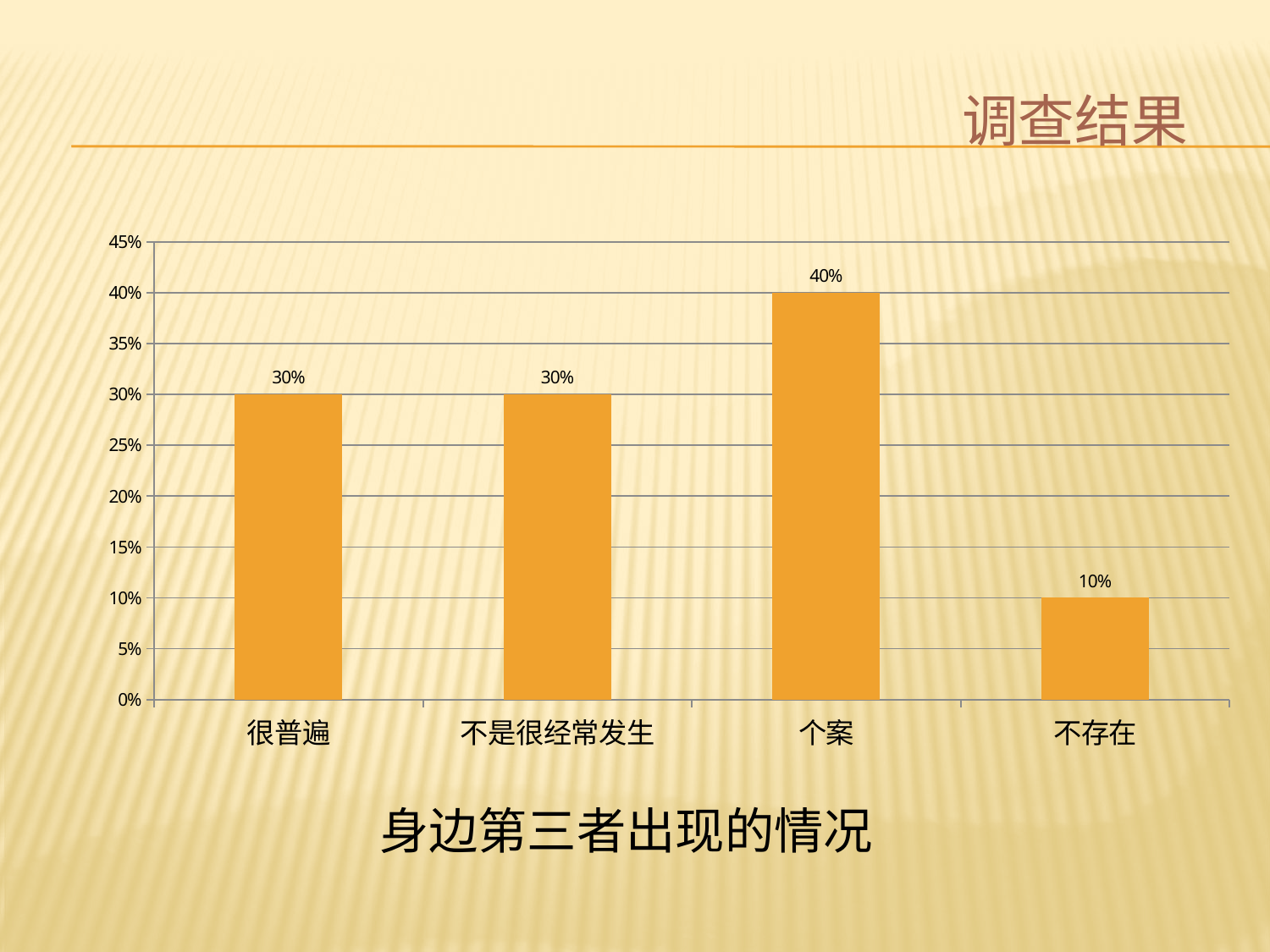
What is the title shown below the chart? 身边第三者出现的情况 Which category has the highest value? 个案 What is the difference between the values for 个案 and 不存在? 30% Which category has the lowest value? 不存在 How many categories are shown on the x axis? 4 What is the value for 不存在? 10% What is the value for 个案? 40% What is the value for 很普遍? 30% What is the value for 不是很经常发生? 30% Which is larger, the value for 个案 or the value for 很普遍? 个案 Is the value for 个案 greater or less than 35%? greater What kind of chart is shown on the slide? bar chart